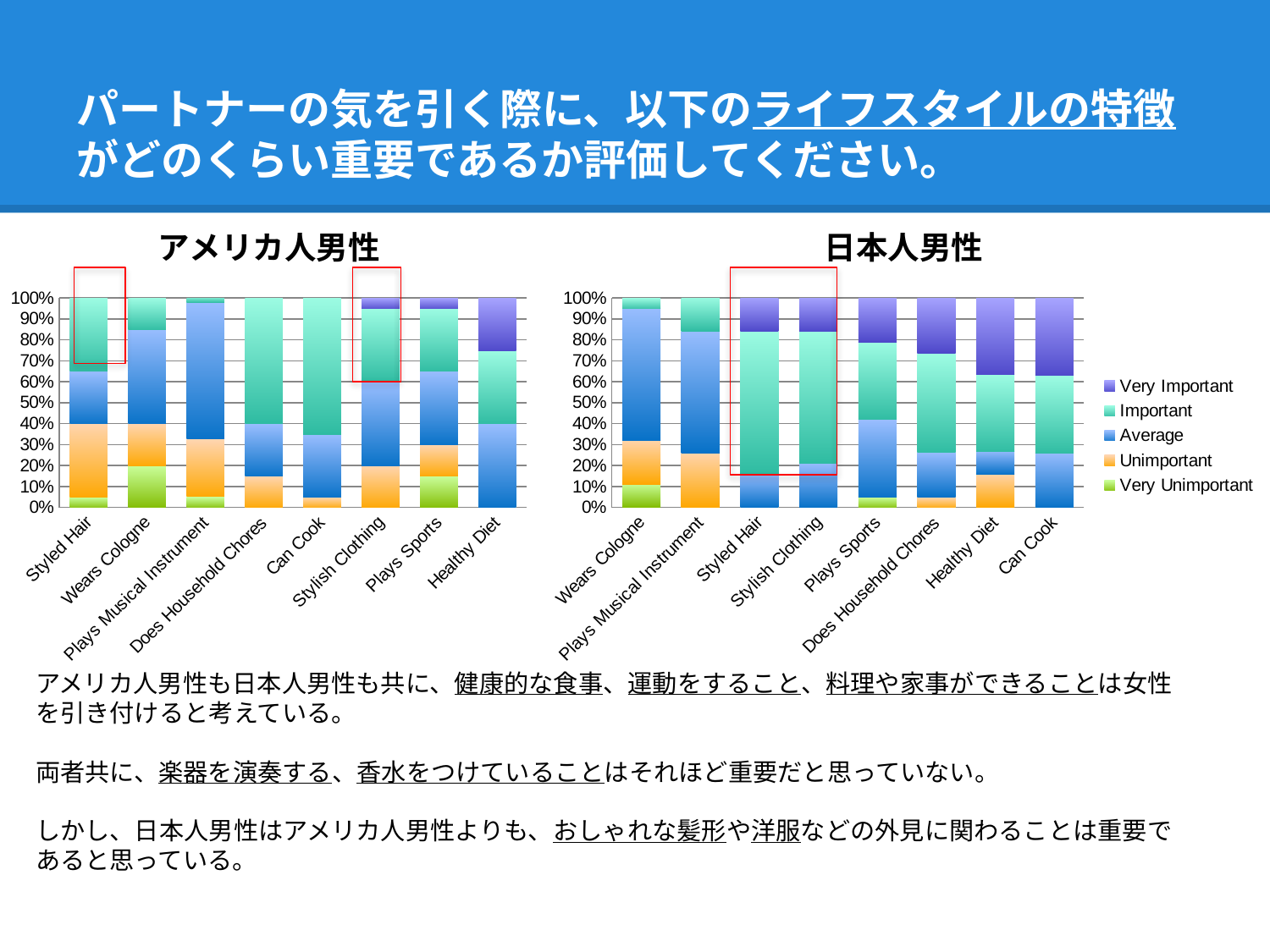
How many categories are shown on the x axis of the 日本人男性 chart? 8 In the 日本人男性 chart, which has the larger Very Important share: Can Cook or Wears Cologne? Can Cook What is the title of the chart on the left? アメリカ人男性 In the アメリカ人男性 chart, which category has the largest Very Important share? Healthy Diet In the アメリカ人男性 chart, is the Important share for Does Household Chores greater or less than 50%? greater What kind of chart is used for the アメリカ人男性 chart? Stacked bar chart In the 日本人男性 chart, which category has the largest Average share? Wears Cologne What are the five series listed in the legend? Very Important, Important, Average, Unimportant, Very Unimportant In the アメリカ人男性 chart, which has the larger Very Important share: Healthy Diet or Plays Sports? Healthy Diet In the アメリカ人男性 chart, which category has the largest Unimportant share? Styled Hair In the 日本人男性 chart, is the Average share for Wears Cologne greater or less than 50%? greater How many series does the legend list? 5